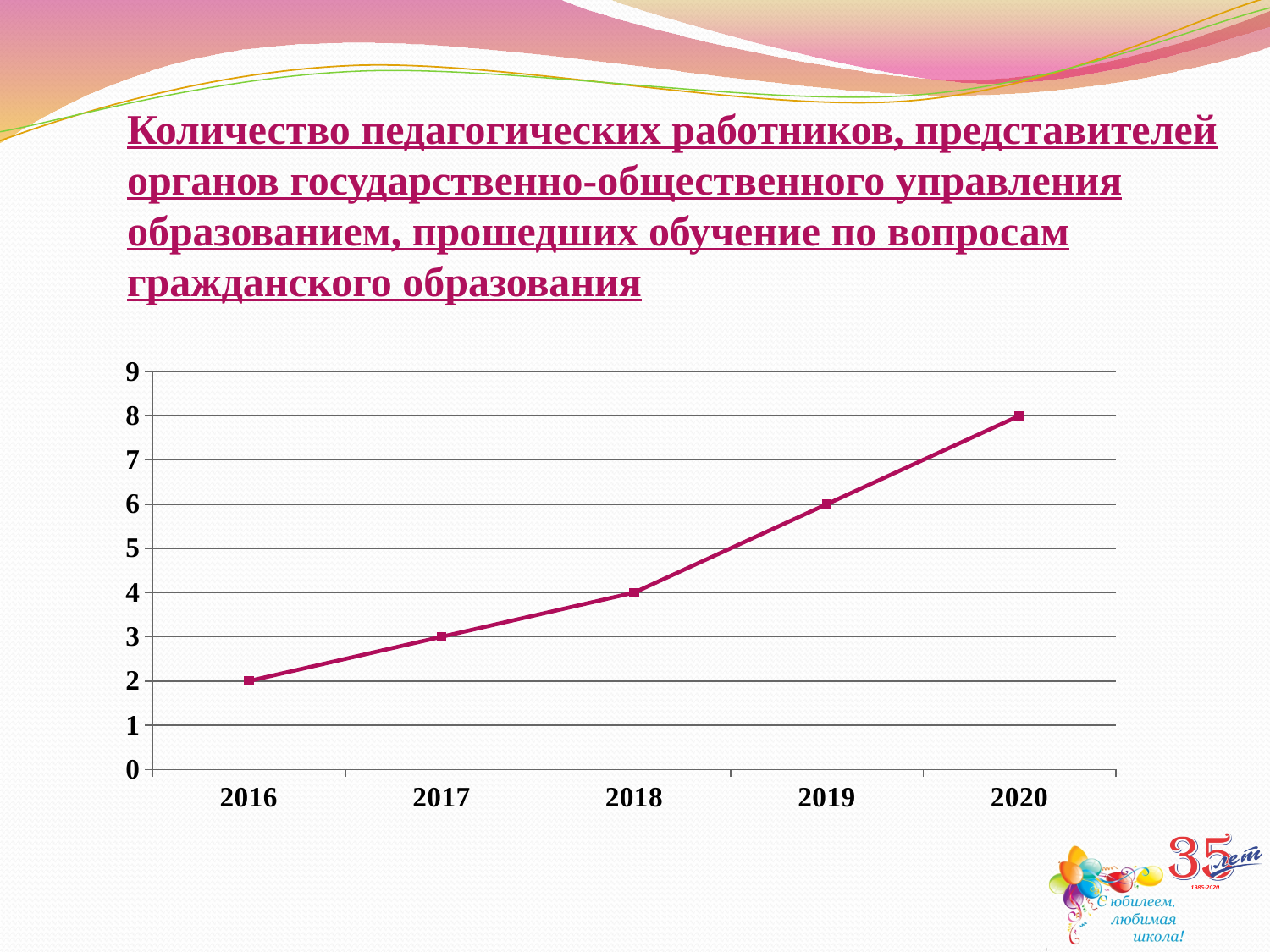
Do the values rise or fall from 2016 to 2020? rise Which year has the highest value? 2020 What is the difference between the values for 2020 and 2016? 6 What is the value for 2016? 2 Which year has a larger value, 2017 or 2019? 2019 How many data points are plotted on the line chart? 5 What is the value for 2020? 8 Which year has the lowest value? 2016 What is the value for 2018? 4 What type of chart is shown on the slide? line chart What is the first year shown on the x axis? 2016 What is the difference between the values for 2019 and 2018? 2